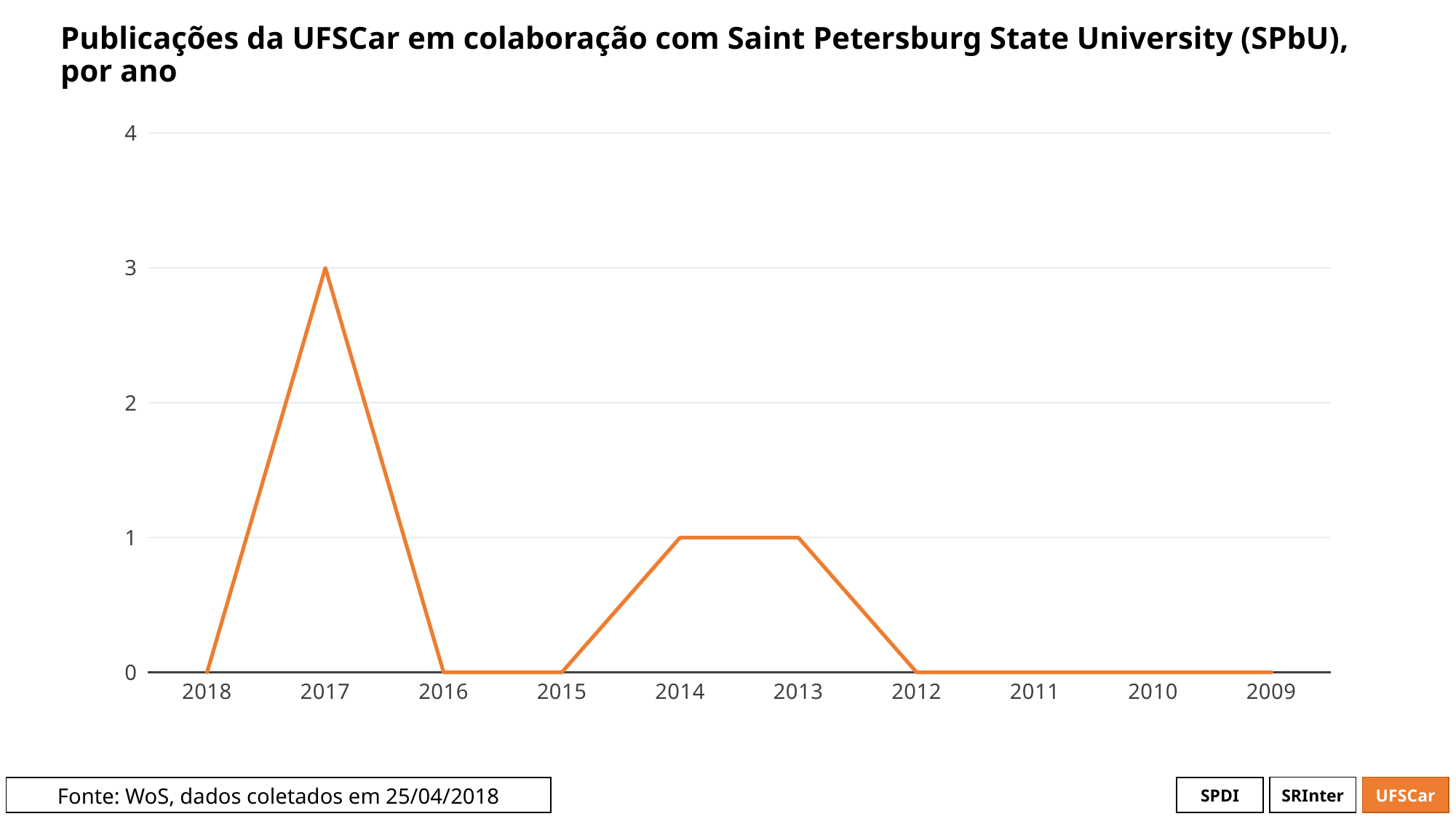
Which year has the highest number of publications? 2017 How many years are shown on the x axis? 10 How many publications are shown for 2018? 0 How many publications are shown for 2013? 1 How many publications are shown for 2014? 1 What is the total number of publications across 2014 and 2013? 2 Is the value for 2017 greater or less than 2? greater What type of chart is shown on the slide? line chart Which year has more publications, 2017 or 2013? 2017 What is the title of the chart? Publicações da UFSCar em colaboração com Saint Petersburg State University (SPbU), por ano How many publications are shown for 2017? 3 What is the difference between the number of publications in 2017 and in 2014? 2